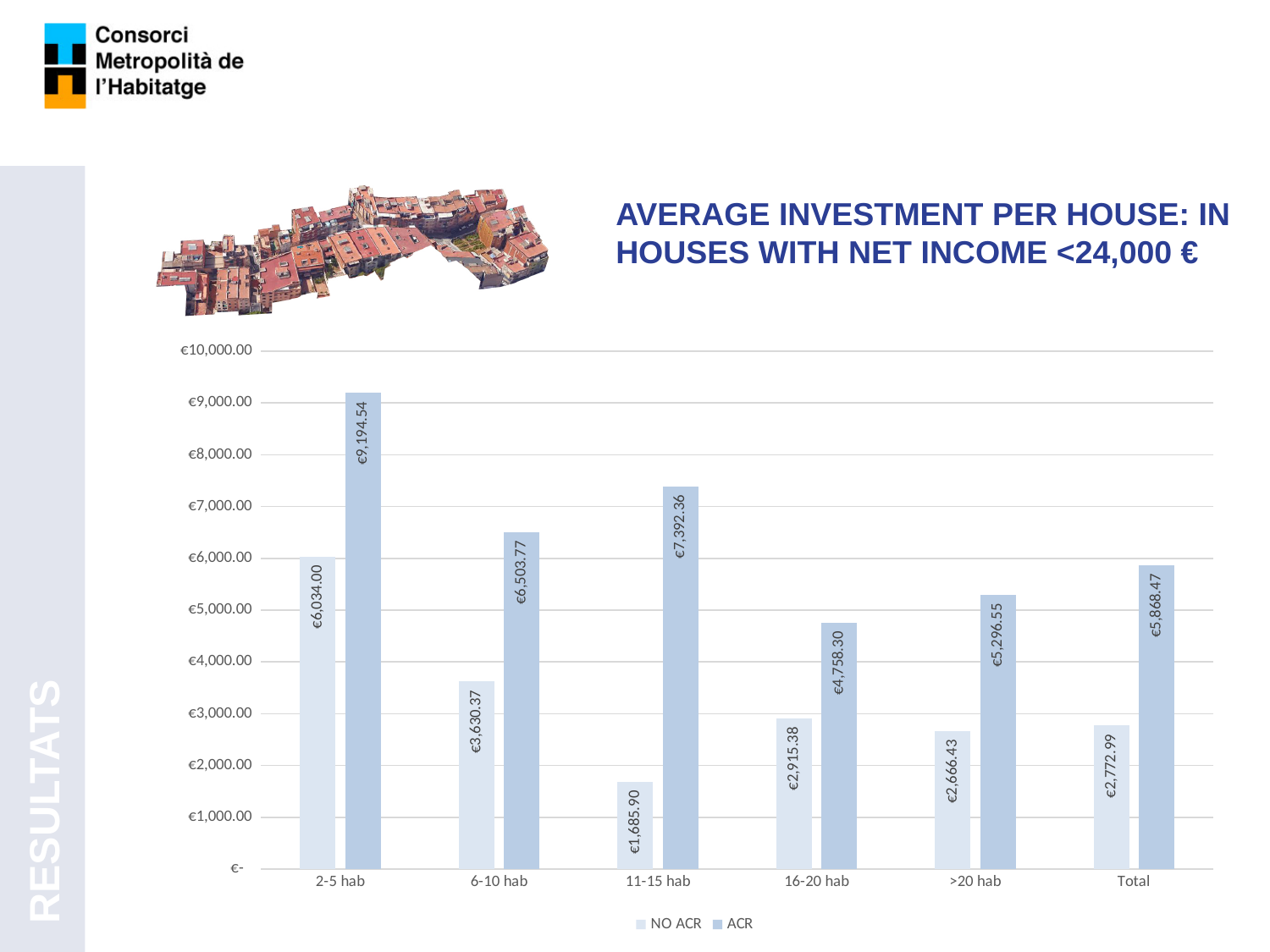
What are the two series named in the legend? NO ACR and ACR What is the difference between the ACR and NO ACR values for 6-10 hab? €2,873.40 Which category has the highest ACR value? 2-5 hab What is the ACR value for 2-5 hab? €9,194.54 What is the NO ACR value for 11-15 hab? €1,685.90 How many categories are shown on the x axis? 6 How many series does the legend list? 2 What is the ACR value for the Total category? €5,868.47 Which is larger for 16-20 hab, the NO ACR value or the ACR value? ACR What kind of chart is shown on the slide? Bar chart Which category has the lowest NO ACR value? 11-15 hab Is the ACR value for >20 hab greater or less than €5,000.00? greater